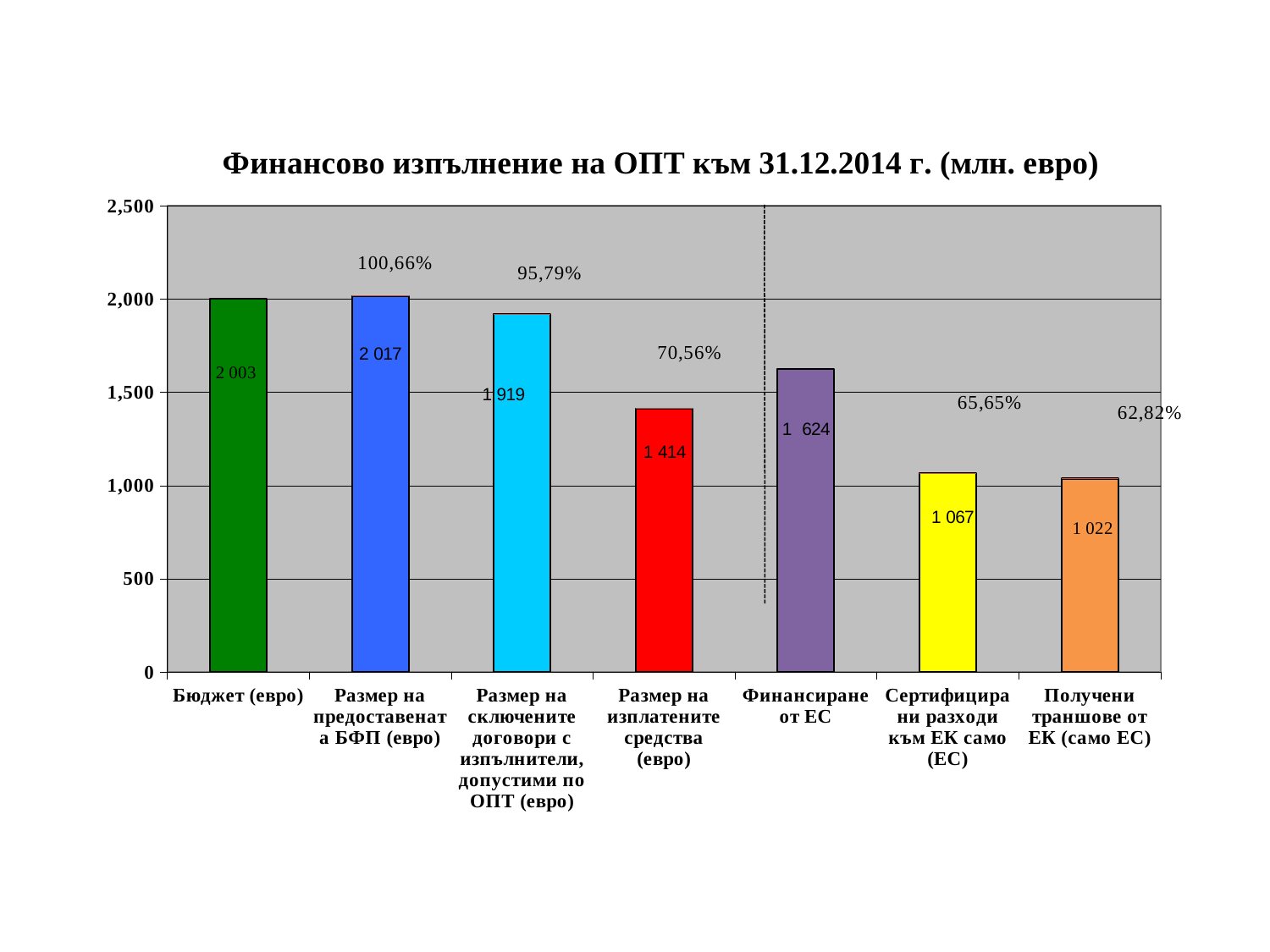
What is the value of the bar for Бюджет (евро)? 2 003 What is the difference between the values for Бюджет (евро) and Размер на изплатените средства (евро)? 589 How many bars are plotted in the chart? 7 What percentage is shown above the bar for Сертифицирани разходи към ЕК само (ЕС)? 65,65% Which category has the lowest bar? Получени траншове от ЕК (само ЕС) What type of chart is shown on the slide? Bar chart What is the title of the chart? Финансово изпълнение на ОПТ към 31.12.2014 г. (млн. евро) What is the value of the bar for Получени траншове от ЕК (само ЕС)? 1 022 Which category has the highest bar? Размер на предоставената БФП (евро) What is the value of the bar for Финансиране от ЕС? 1 624 Which is larger, the value for Финансиране от ЕС or the value for Сертифицирани разходи към ЕК само (ЕС)? Финансиране от ЕС What is the value of the bar for Размер на изплатените средства (евро)? 1 414